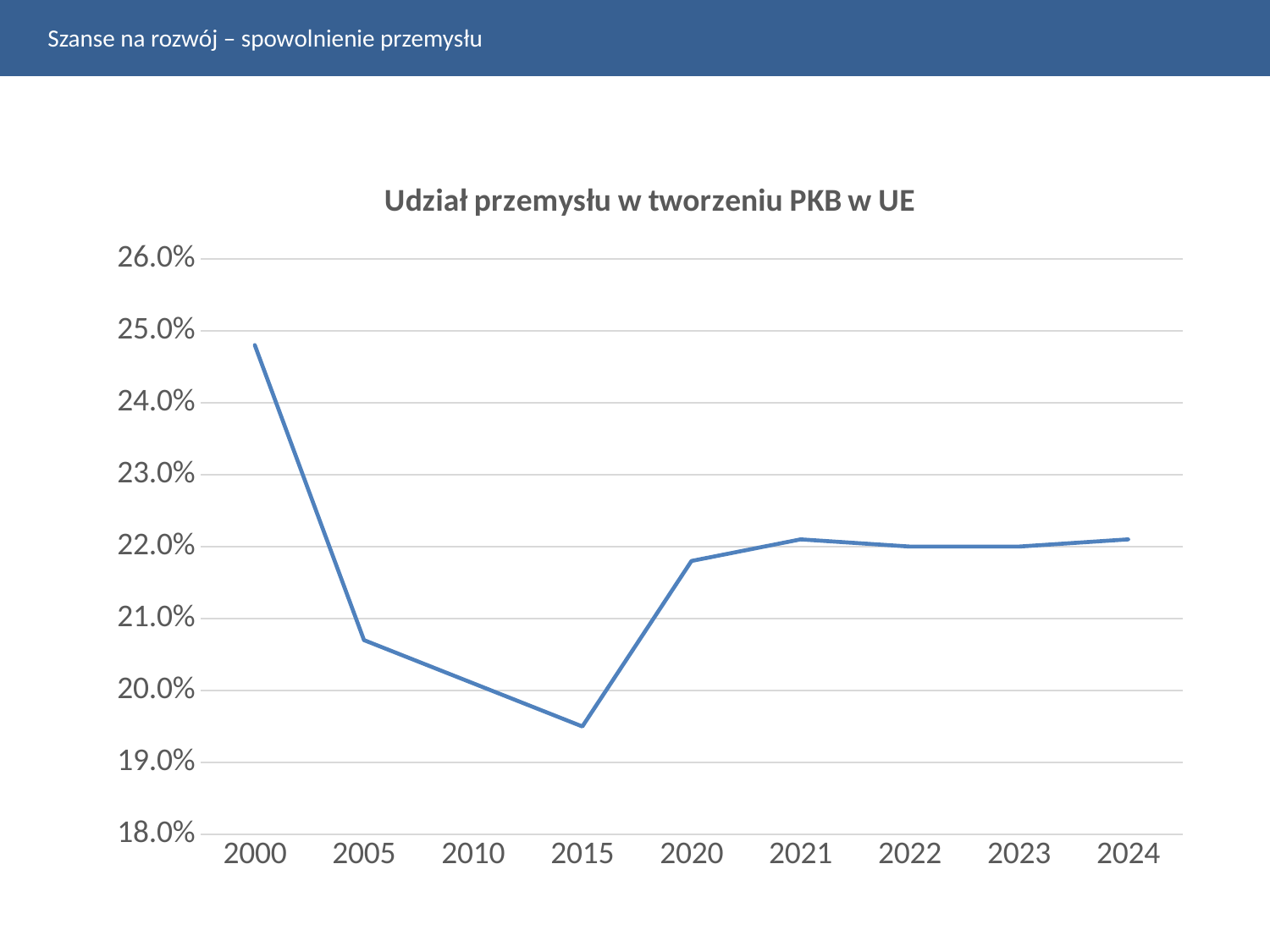
Is the value for 2000 greater or less than 24.0%? greater How many years are shown on the x axis of the chart? 9 Which year has the highest value on the chart? 2000 What is the title of the chart? Udział przemysłu w tworzeniu PKB w UE Is the value for 2015 greater or less than 20.0%? less What type of chart is shown on the slide? line chart Does the value rise or fall between 2000 and 2015? fall Which is larger, the value for 2010 or the value for 2021? 2021 Is the value for 2005 greater or less than 21.0%? less Which year has the lowest value on the chart? 2015 Which is larger, the value for 2000 or the value for 2024? 2000